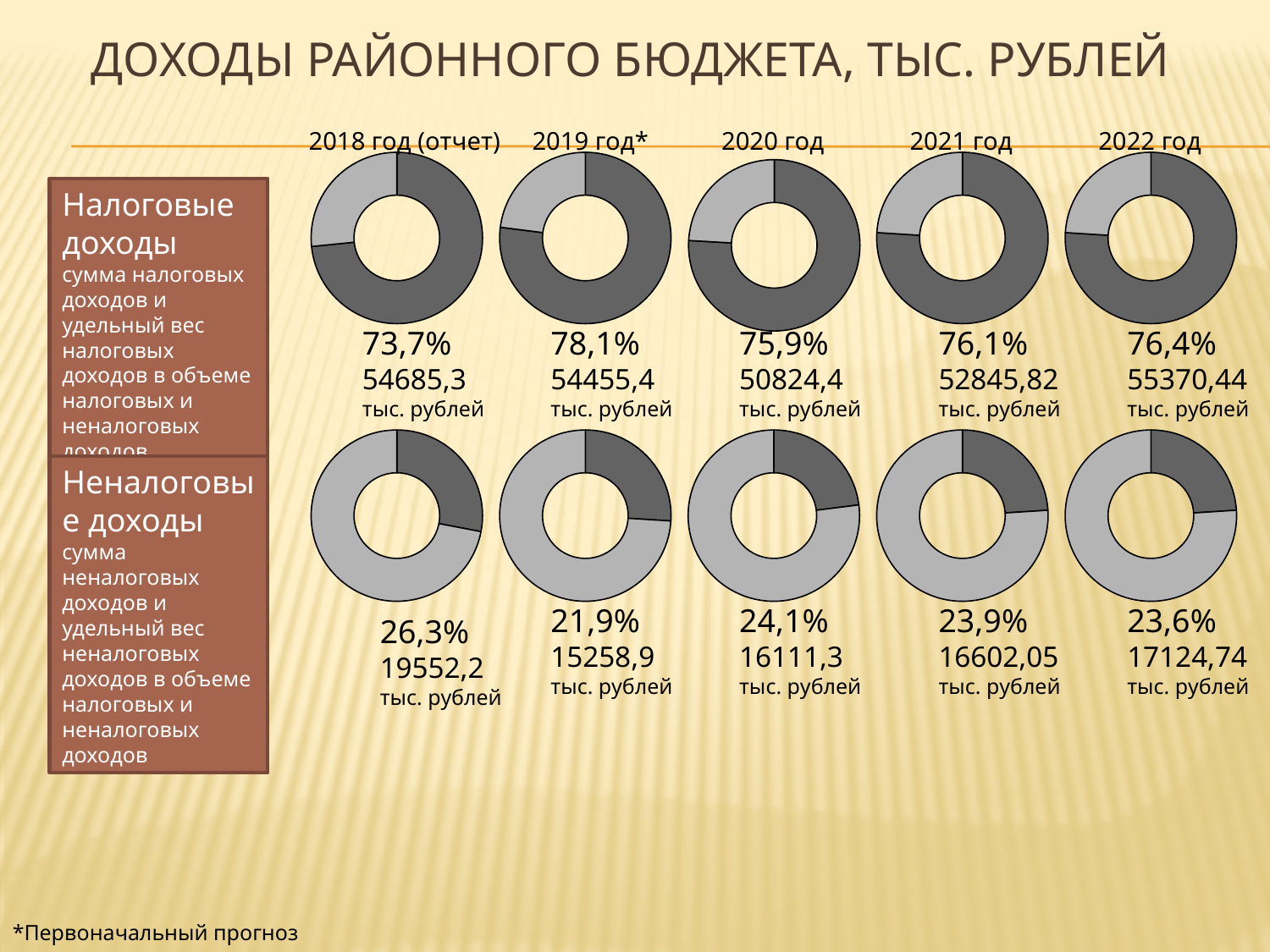
In the top row (Налоговые доходы), which year has the lowest amount in тыс. рублей? 2020 год In the top row (Налоговые доходы), what share is shown for 2019 год*? 78,1% What is the sum of the Налоговые доходы share and the Неналоговые доходы share for 2020 год? 100% In the top row (Налоговые доходы), which year has the highest percentage share? 2019 год* How many donut charts are shown on the slide in total? 10 In the top row (Налоговые доходы), what is the difference between the 2022 год amount and the 2018 год (отчет) amount in тыс. рублей? 685,14 In the bottom row (Неналоговые доходы), which year has the larger amount: 2019 год* or 2020 год? 2020 год In the top row (Налоговые доходы), what amount in тыс. рублей is shown for 2020 год? 50824,4 тыс. рублей In the bottom row (Неналоговые доходы), what amount in тыс. рублей is shown for 2021 год? 16602,05 тыс. рублей In the bottom row (Неналоговые доходы), which year has the highest percentage share? 2018 год (отчет) What kind of chart is used on this slide? Donut (pie) chart In the bottom row (Неналоговые доходы), do the amounts in тыс. рублей rise or fall from 2019 год* to 2022 год? Rise